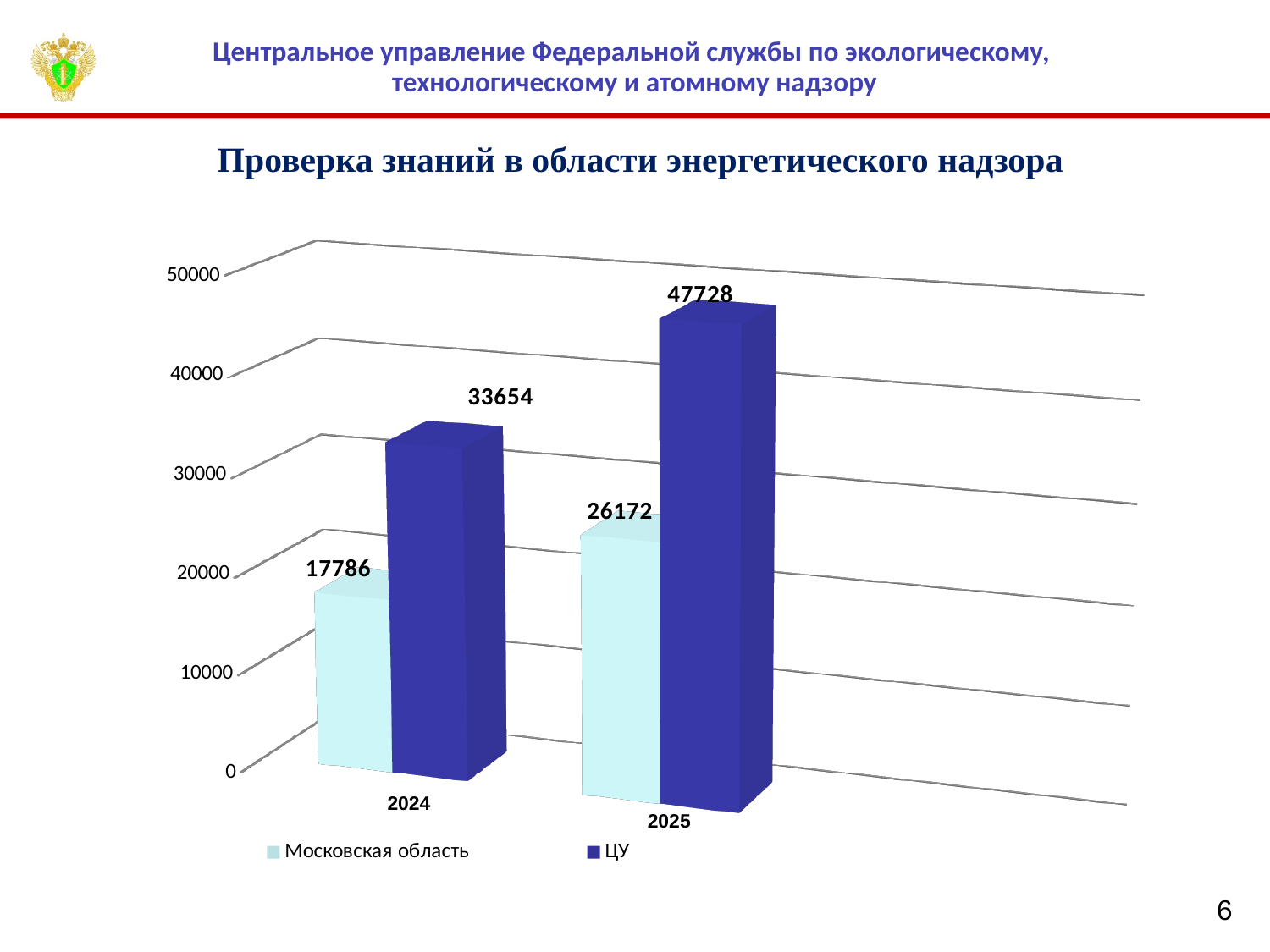
What is the value for Московская область in 2025? 26172 Which is larger: the ЦУ value in 2024 or the Московская область value in 2025? ЦУ in 2024 Which series has the lowest value in 2024? Московская область By how much did the Московская область value increase from 2024 to 2025? 8386 What kind of chart is shown on the slide? Bar chart Which year has the highest value for ЦУ? 2025 What is the value for Московская область in 2024? 17786 How many series does the legend list? 2 Do the values for ЦУ rise or fall from 2024 to 2025? Rise What is the value for ЦУ in 2024? 33654 What is the value for ЦУ in 2025? 47728 What is the difference between the ЦУ value and the Московская область value in 2025? 21556